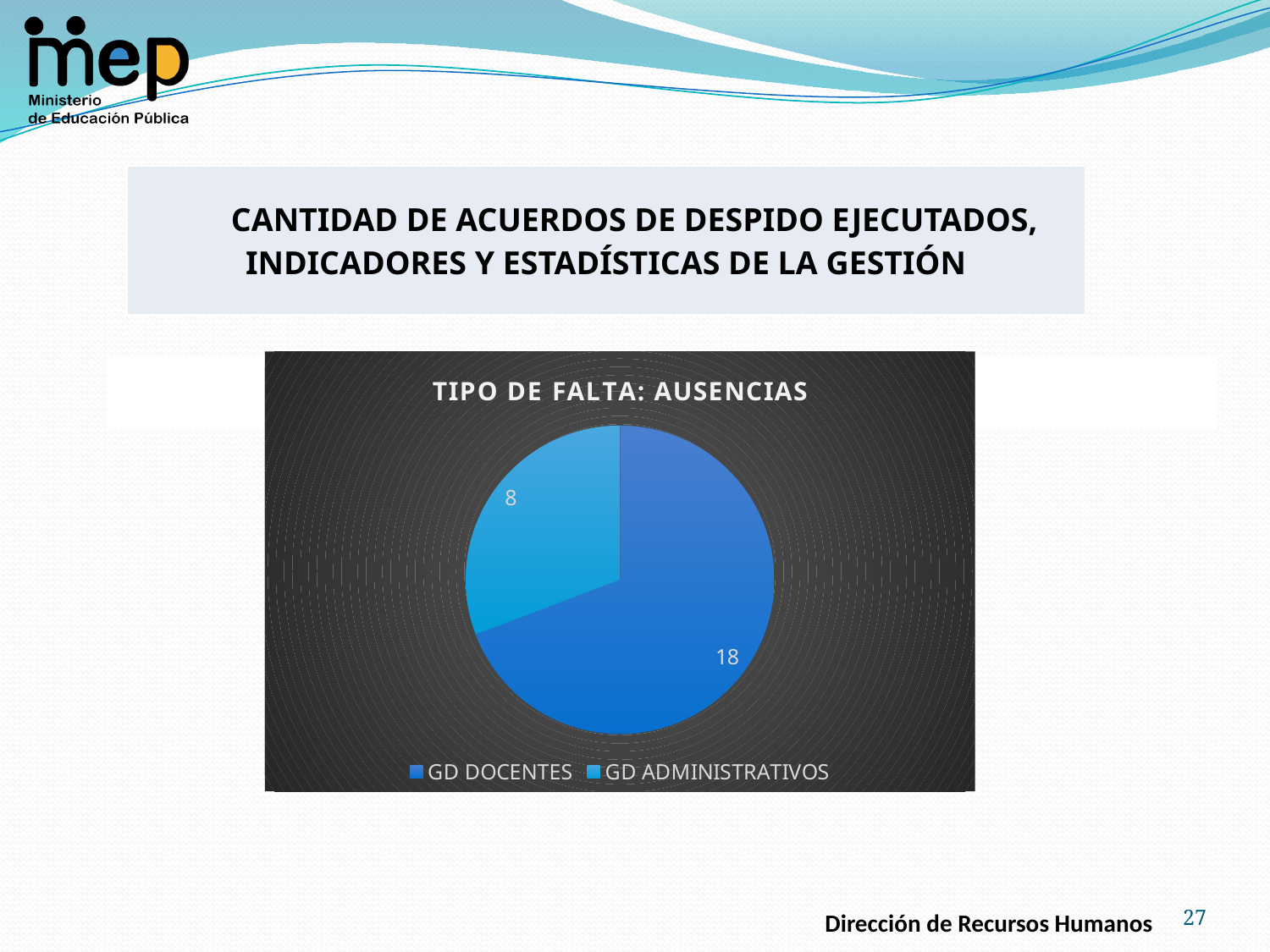
How many entries does the legend list? 2 Which category has the smallest slice of the pie? GD ADMINISTRATIVOS What is the value for GD ADMINISTRATIVOS? 8 Which category has the largest slice of the pie? GD DOCENTES How many categories does the pie chart show? 2 What is the difference between the values for GD DOCENTES and GD ADMINISTRATIVOS? 10 What is the total of all slices in the pie chart? 26 What type of chart is shown on the slide? Pie chart What is the title of the chart? TIPO DE FALTA: AUSENCIAS Which legend entry is shown in the lighter blue colour? GD ADMINISTRATIVOS What is the value for GD DOCENTES? 18 Which is larger, the value for GD DOCENTES or GD ADMINISTRATIVOS? GD DOCENTES